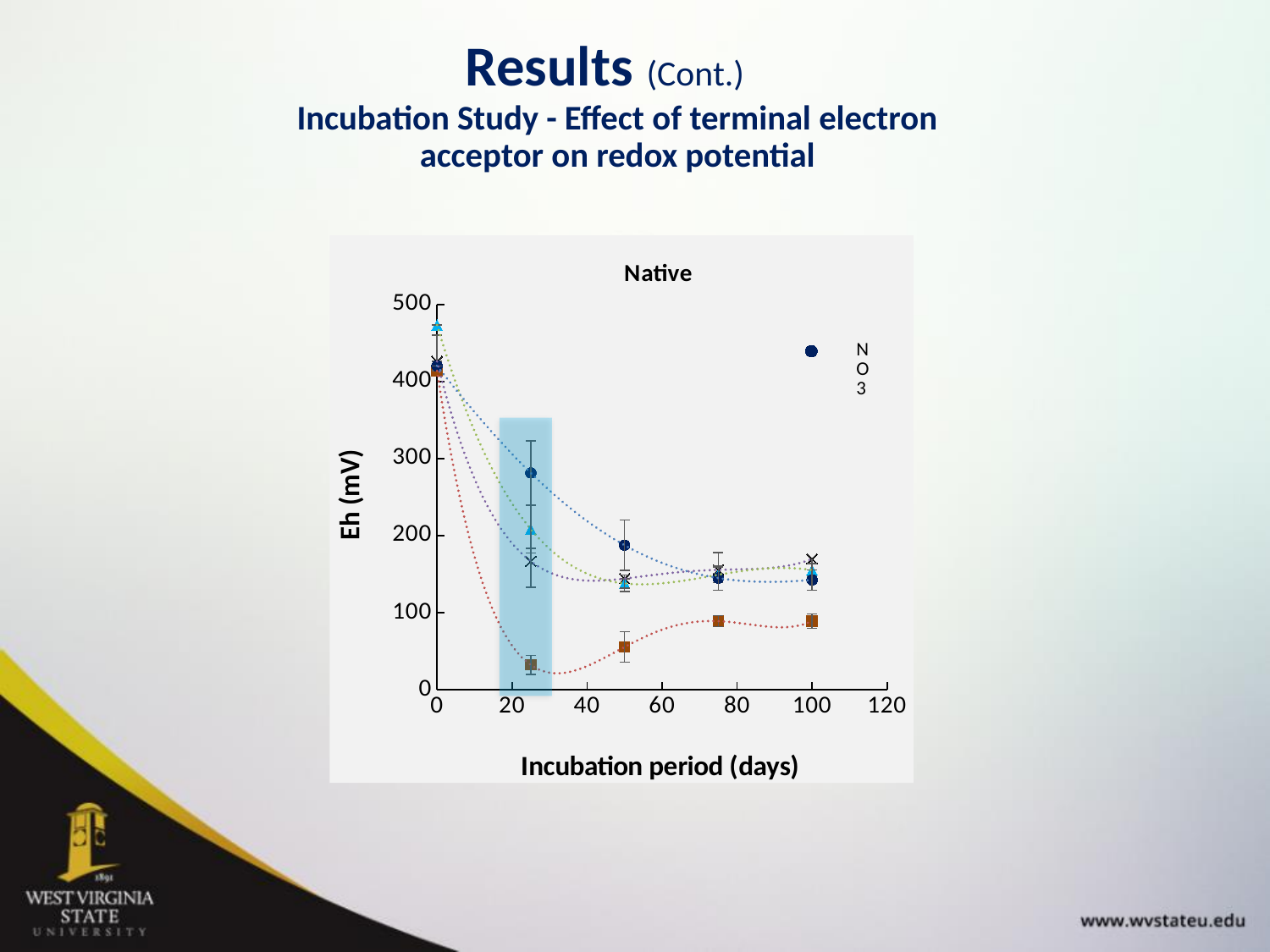
Is the value of the NO3 series at 100 days greater or less than 200? less What is the title of the chart? Native Is the value of the brown square series at 50 days greater or less than 100? less What is the label of the y axis? Eh (mV) How many incubation time points are plotted for the NO3 series? 5 Is the value of the brown square series at 20 days greater or less than 100? less What kind of chart is shown on the slide? Scatter chart with dotted trend lines At 20 days, which is larger: the NO3 series or the brown square series? NO3 Does the NO3 series rise or fall from 0 days to 100 days? Fall Which series has the lowest value at 20 days? The brown square series Which series is named in the chart's legend? NO3